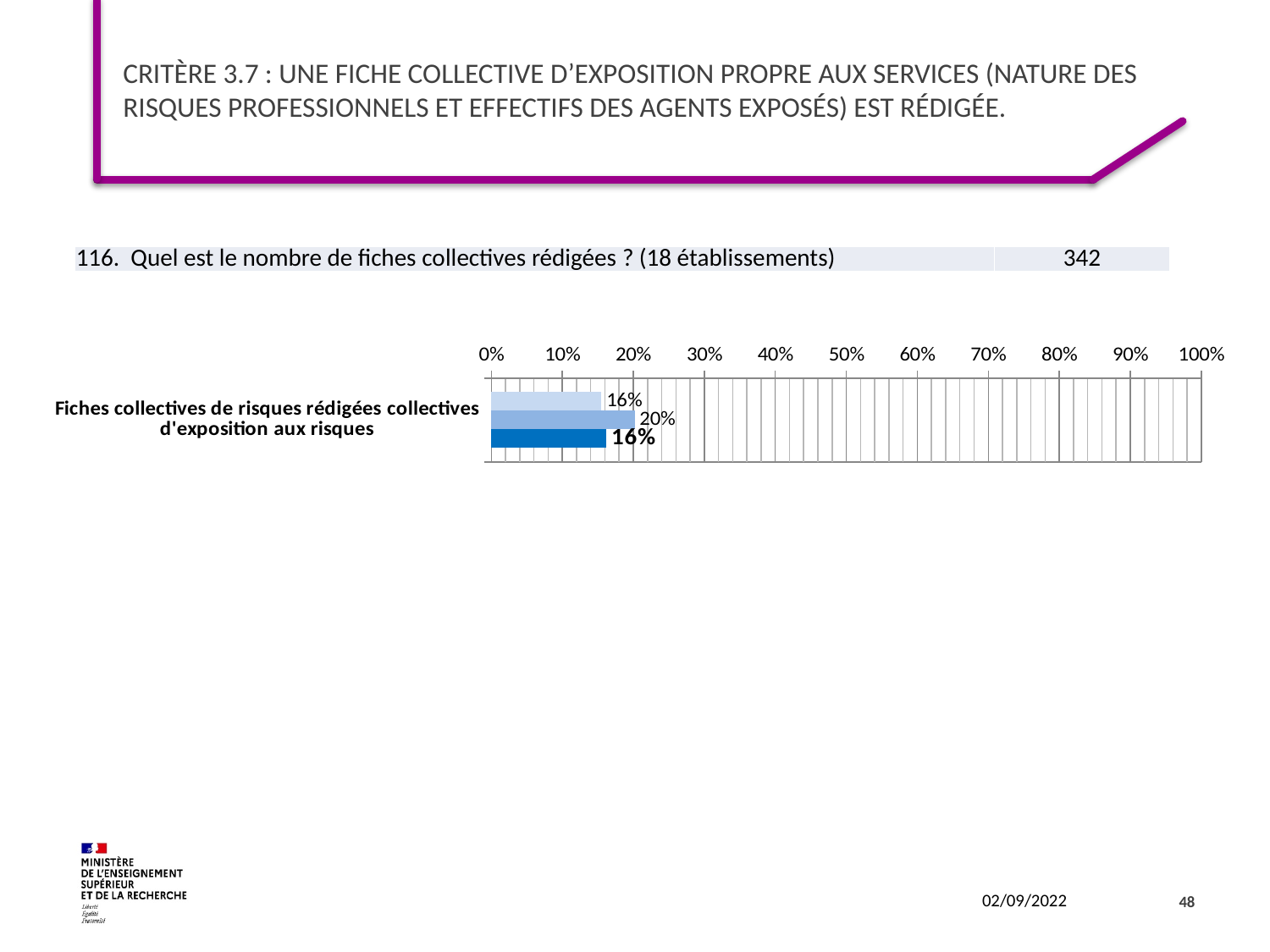
What is the maximum value shown on the chart's horizontal axis? 100% What is the category label shown on the chart's vertical axis? Fiches collectives de risques rédigées collectives d'exposition aux risques What is the value of the middle bar in the chart? 20% How many categories are shown on the chart's vertical axis? 1 Which is larger, the value of the middle bar or the value of the top bar? middle bar How many bars are plotted in the chart? 3 What is the value of the bottom (darkest blue) bar in the chart? 16% Which bar has the highest value: the top, middle or bottom bar? middle What is the difference between the middle bar's value and the bottom bar's value? 4% Is the value of the middle bar greater or less than 30%? less What is the value of the top (lightest blue) bar in the chart? 16% What kind of chart is shown on the slide? bar chart